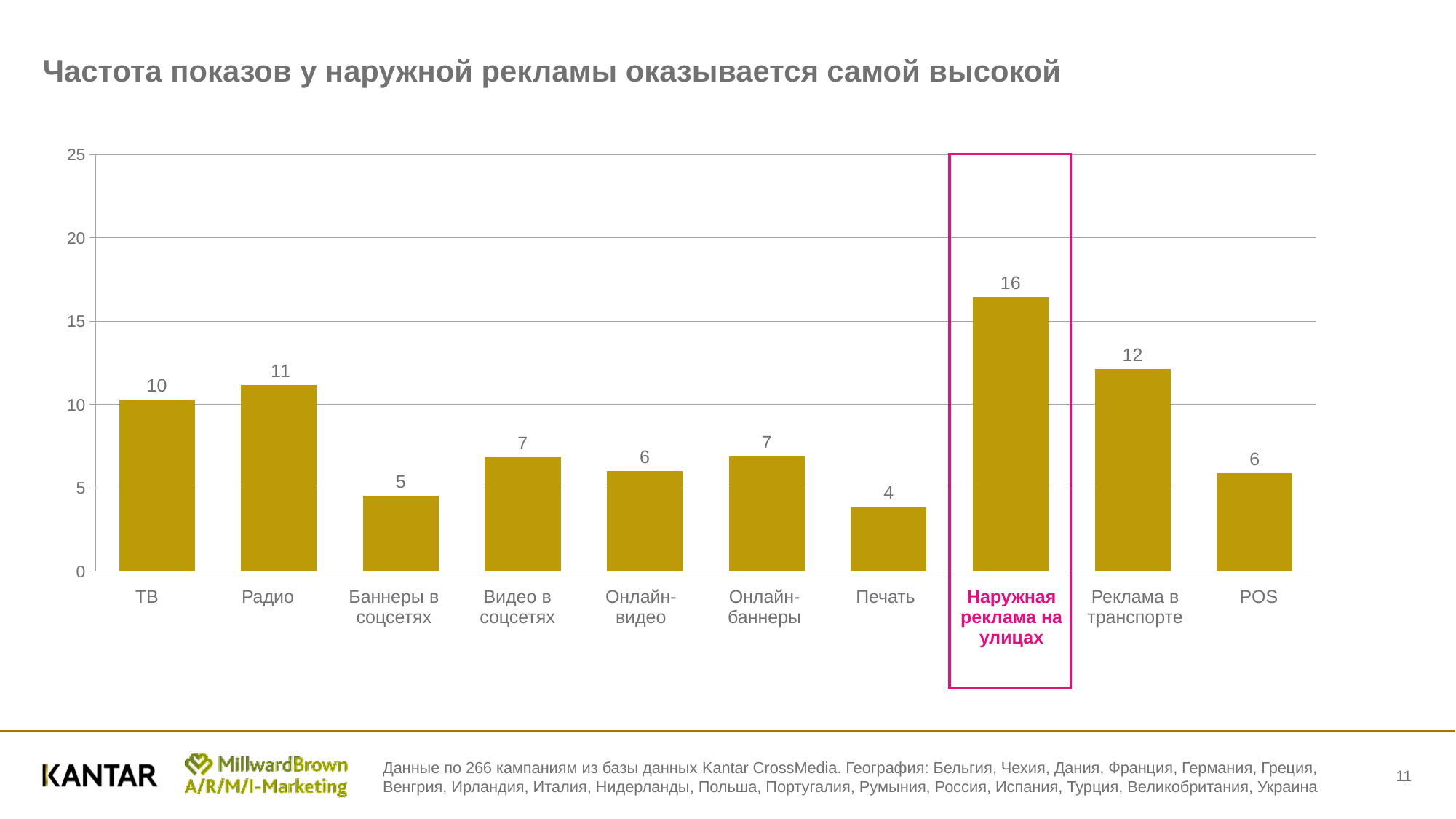
Which category has the highest value? Наружная реклама на улицах What is the value for Радио? 11 How many categories are shown on the x axis? 10 Which is larger, the value for ТВ or the value for Радио? Радио What kind of chart is shown on the slide? bar chart What is the value for Наружная реклама на улицах? 16 What is the difference between the values for Наружная реклама на улицах and Реклама в транспорте? 4 Which category is highlighted with a pink outline? Наружная реклама на улицах Which category has the lowest value? Печать Is the value for Наружная реклама на улицах greater or less than 15? greater What is the value for Реклама в транспорте? 12 What is the value for Печать? 4